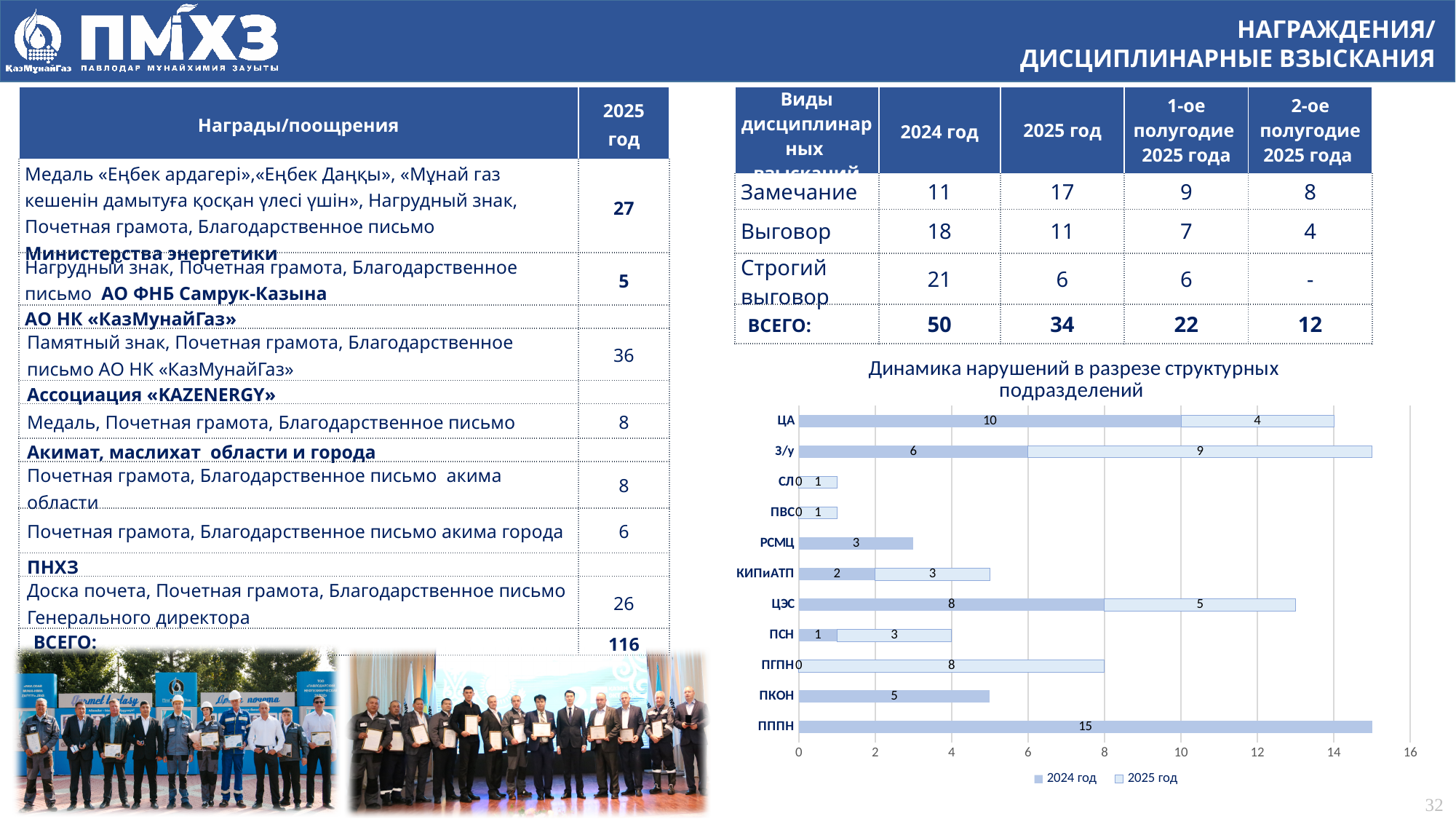
What type of chart is shown under the title "Динамика нарушений в разрезе структурных подразделений"? bar chart Which is larger on the chart: the 2024 год value for ПКОН or the 2024 год value for РСМЦ? ПКОН What is the 2025 год value for ПГПН on the chart? 8 What is the total of the stacked bar for ЦЭС on the chart? 13 What is the 2024 год value for ПППН on the chart? 15 What are the two legend entries of the chart? 2024 год, 2025 год How many structural subdivisions (categories) are shown on the chart? 11 What is the 2024 год value for ЦА on the chart? 10 What is the 2025 год value for З/у on the chart? 9 What is the difference between the 2024 год and 2025 год values for ЦА on the chart? 6 Which subdivision has the highest 2024 год value on the chart? ПППН How many series does the legend of the chart list? 2